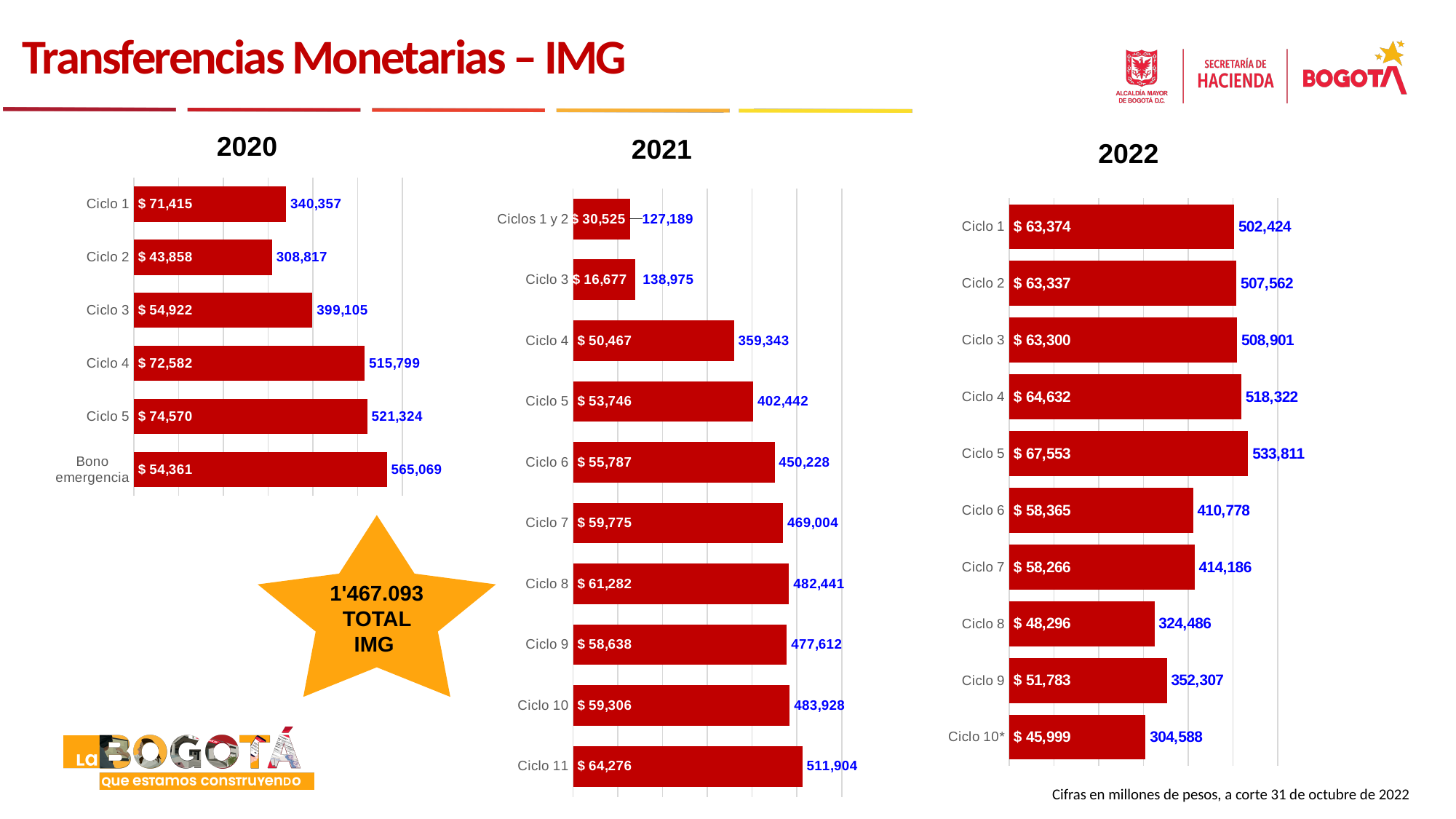
In the 2021 chart, what is the dollar value printed inside the bar for Ciclo 11? $ 64,276 In the 2021 chart, which category has the lowest dollar value printed inside its bar? Ciclo 3 In the 2022 chart, what is the blue number printed at the end of the Ciclo 5 bar? 533,811 In the 2020 chart, which category has the shortest bar? Ciclo 2 In the 2022 chart, which category has the longest bar? Ciclo 5 What type of chart is used for the 2022 data? Bar chart How many categories are shown in the 2021 chart? 10 In the 2020 chart, what is the dollar value printed inside the bar for Ciclo 4? $ 72,582 In the 2020 chart, what is the blue number printed at the end of the Bono emergencia bar? 565,069 What total IMG figure is shown in the yellow star on the slide? 1'467.093 In the 2022 chart, what is the difference between the blue numbers for Ciclo 1 and Ciclo 10*? 197,836 In the 2021 chart, which has the larger dollar value inside its bar: Ciclo 8 or Ciclo 9? Ciclo 8